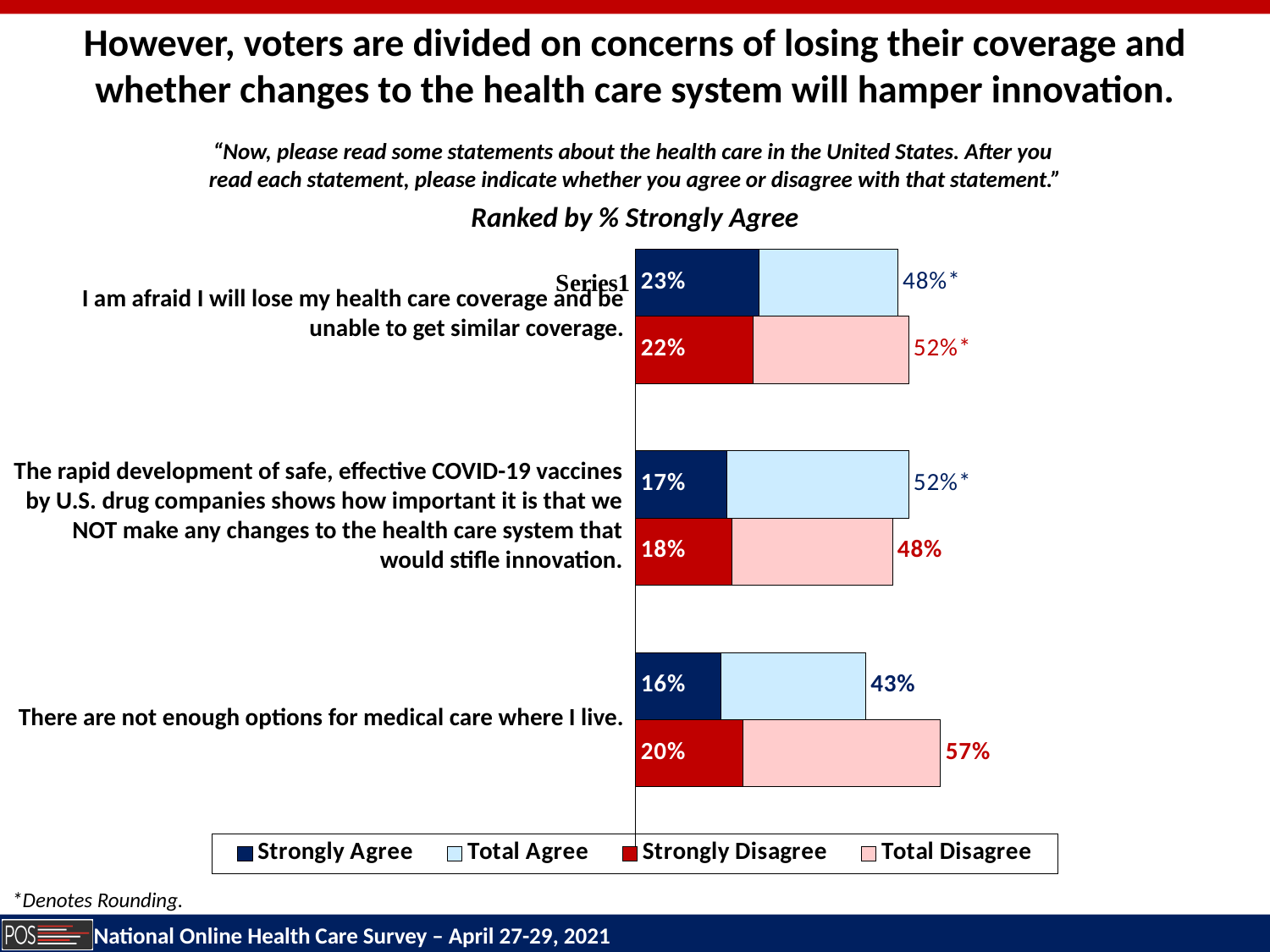
What is the Strongly Agree value for the statement 'I am afraid I will lose my health care coverage and be unable to get similar coverage'? 23% What is the difference between the Total Disagree and Total Agree values for the statement 'There are not enough options for medical care where I live'? 14% For the statement about the rapid development of COVID-19 vaccines, which is larger: Total Agree or Total Disagree? Total Agree What is the Total Disagree value for the statement 'There are not enough options for medical care where I live'? 57% How many statements are plotted in the chart? 3 What is the Strongly Disagree value for the statement about the rapid development of COVID-19 vaccines? 18% Which statement has the lowest Strongly Agree value? There are not enough options for medical care where I live. Which legend entry is shown in dark navy blue? Strongly Agree How many series does the chart legend list? 4 Which statement has the highest Strongly Agree value? I am afraid I will lose my health care coverage and be unable to get similar coverage. What type of chart is shown on the slide? bar chart What is the Total Agree value for the statement 'There are not enough options for medical care where I live'? 43%